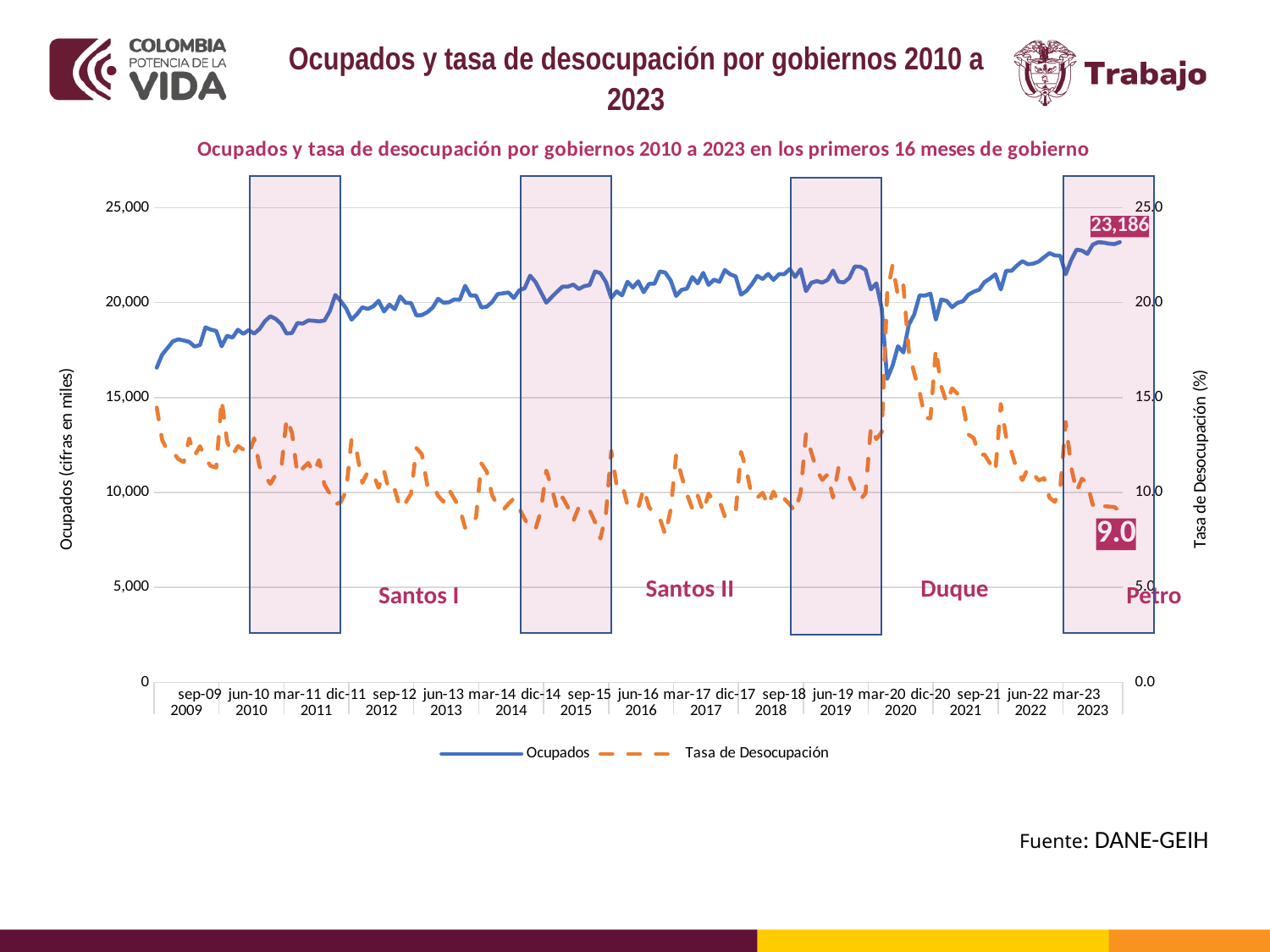
Which series is drawn with a dashed orange line? Tasa de Desocupación Is the Ocupados value in 2023 greater or less than 20,000? greater Is the peak of the Tasa de Desocupación series in 2020 greater or less than 15.0? greater What is the last labelled value of the Ocupados series? 23,186 Does the Ocupados series generally rise or fall from 2009 to 2023? rise Which is larger, the Ocupados value at the end of the series in 2023 or at the start in 2009? 2023 Is the Ocupados value at the start of the series (sep-09) greater or less than 20,000? less What is the last labelled value of the Tasa de Desocupación series? 9.0 How many series does the legend list? 2 Which four governments are labelled in the shaded regions of the chart? Santos I, Santos II, Duque, Petro What kind of chart is shown on the slide? line chart